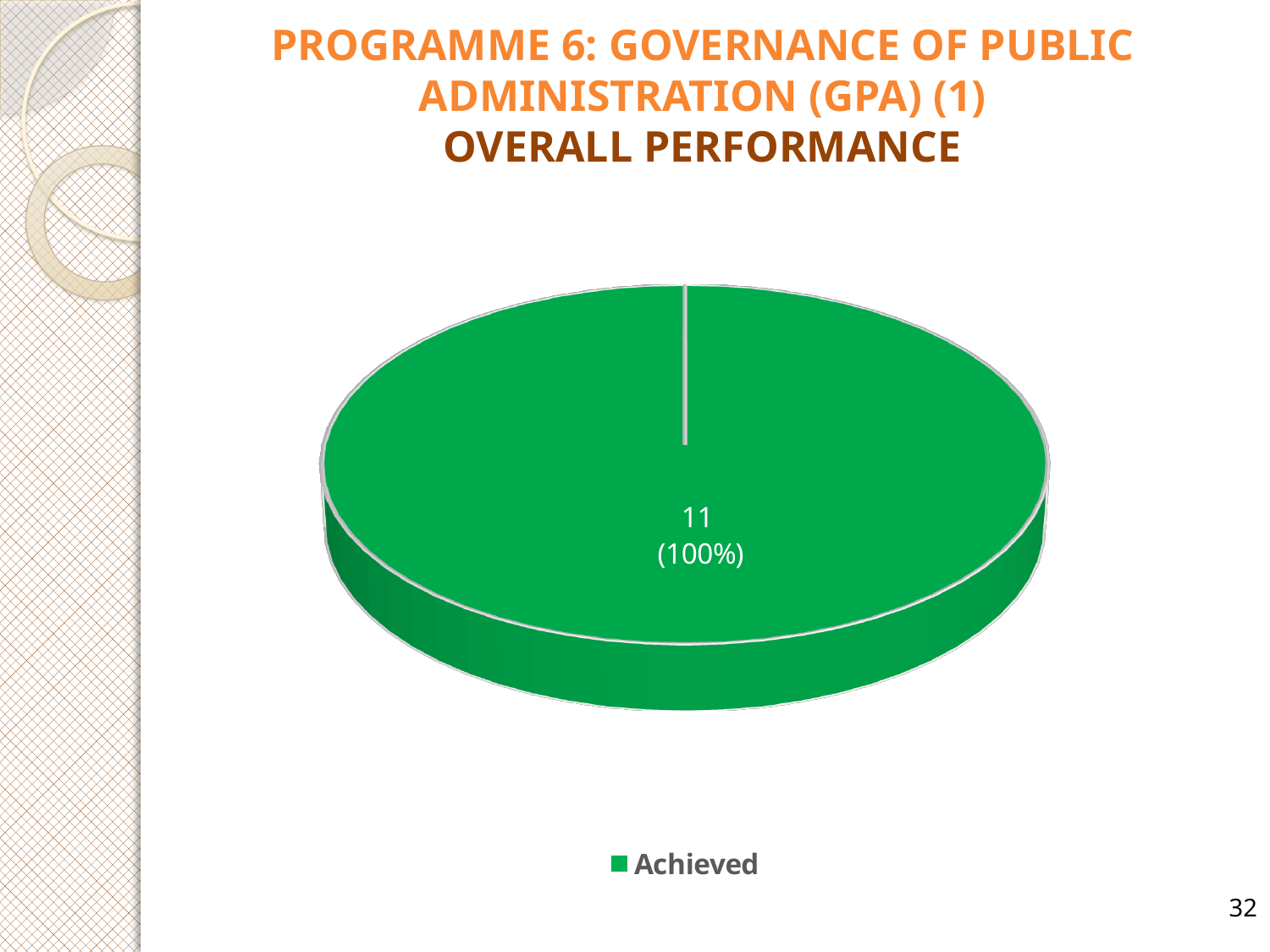
How many slices does the pie chart have? 1 What is the total of all slices in the pie chart? 11 How many entries does the legend list? 1 What is the value shown for the Achieved slice? 11 What colour is the Achieved slice? Green Which category makes up the entire pie? Achieved What percentage share of the pie does the Achieved slice represent? 100% What is the label of the only legend entry? Achieved What kind of chart is shown on the slide? Pie chart